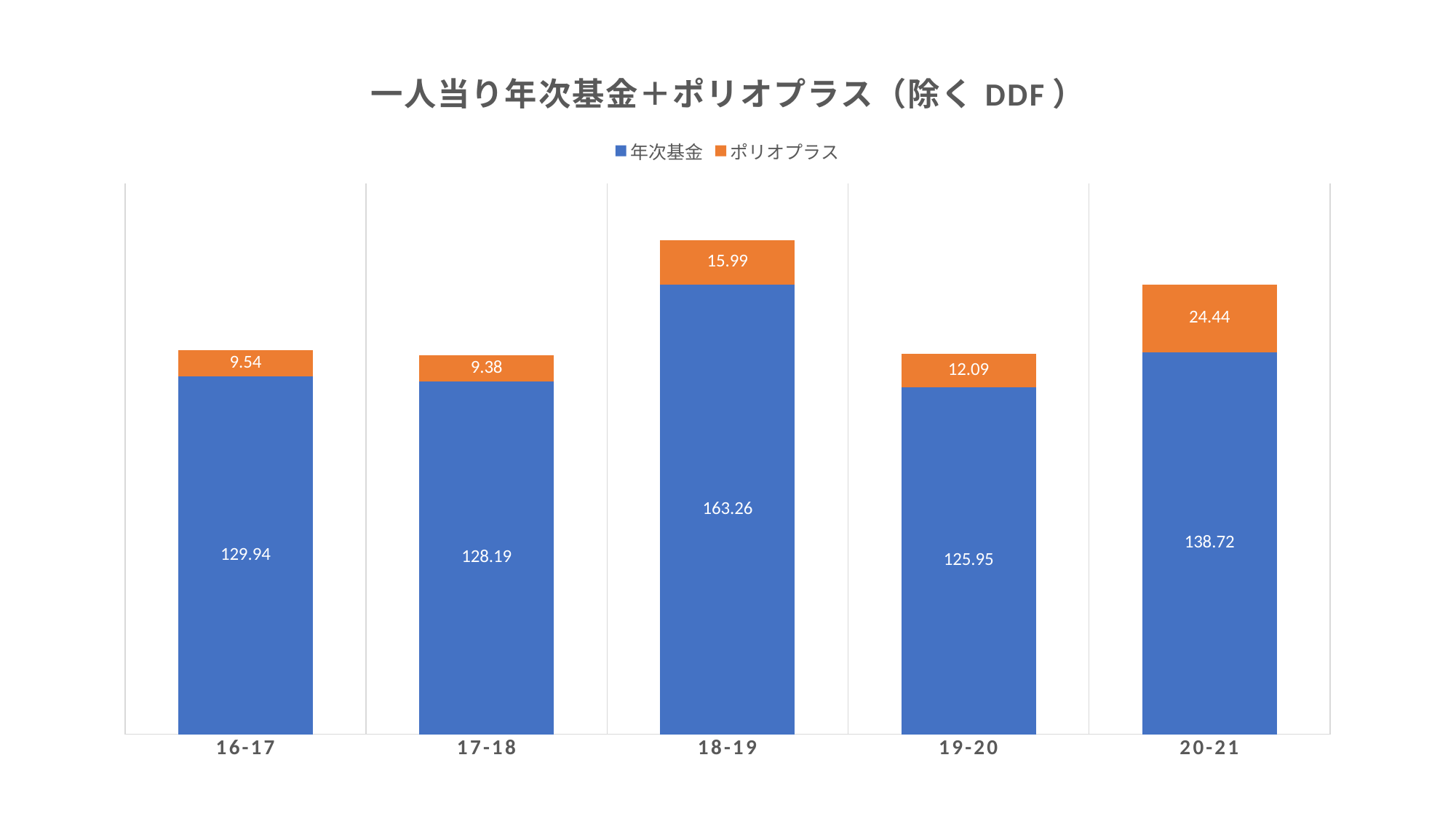
How many years are shown on the x axis? 5 What is the total of the stacked bar for 20-21? 163.16 Which year has the highest 年次基金 value? 18-19 How many series does the legend list? 2 What is the difference between the 年次基金 values for 18-19 and 19-20? 37.31 Which year has the lowest ポリオプラス value? 17-18 Which is larger, the ポリオプラス value for 16-17 or for 19-20? 19-20 What is the 年次基金 value for 18-19? 163.26 What is the ポリオプラス value for 20-21? 24.44 What is the 年次基金 value for 19-20? 125.95 Which colour represents ポリオプラス in the chart? Orange What kind of chart is shown? Stacked bar chart